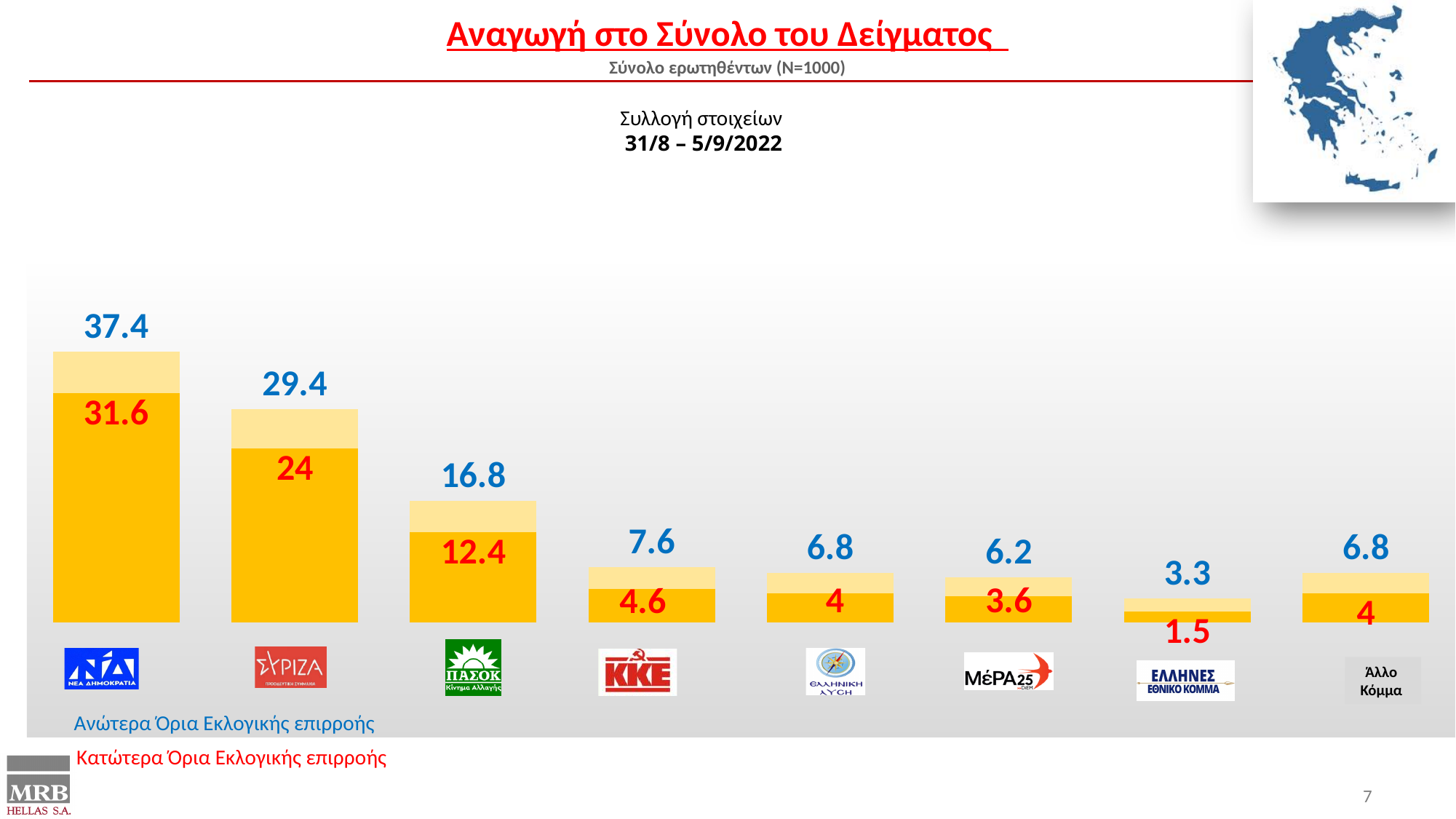
What is the upper limit value shown for ΠΑΣΟΚ? 16.8 What is the difference between the upper limits of ΣΥΡΙΖΑ and ΠΑΣΟΚ? 12.6 What is the difference between the upper and lower limits for Νέα Δημοκρατία? 5.8 What is the upper limit of electoral influence (Ανώτερα Όρια) shown for Νέα Δημοκρατία? 37.4 What is the lower limit of electoral influence (Κατώτερα Όρια) shown for ΣΥΡΙΖΑ? 24 Which has a higher upper limit, ΚΚΕ or ΜέΡΑ25? ΚΚΕ Which party has the lowest lower limit of electoral influence? Έλληνες Εθνικό Κόμμα Which party has the highest upper limit of electoral influence? Νέα Δημοκρατία What type of chart is shown on the slide? Bar chart What is the lower limit value shown for Έλληνες Εθνικό Κόμμα? 1.5 What is the lower limit value shown for ΚΚΕ? 4.6 How many parties/categories are shown in the chart? 8